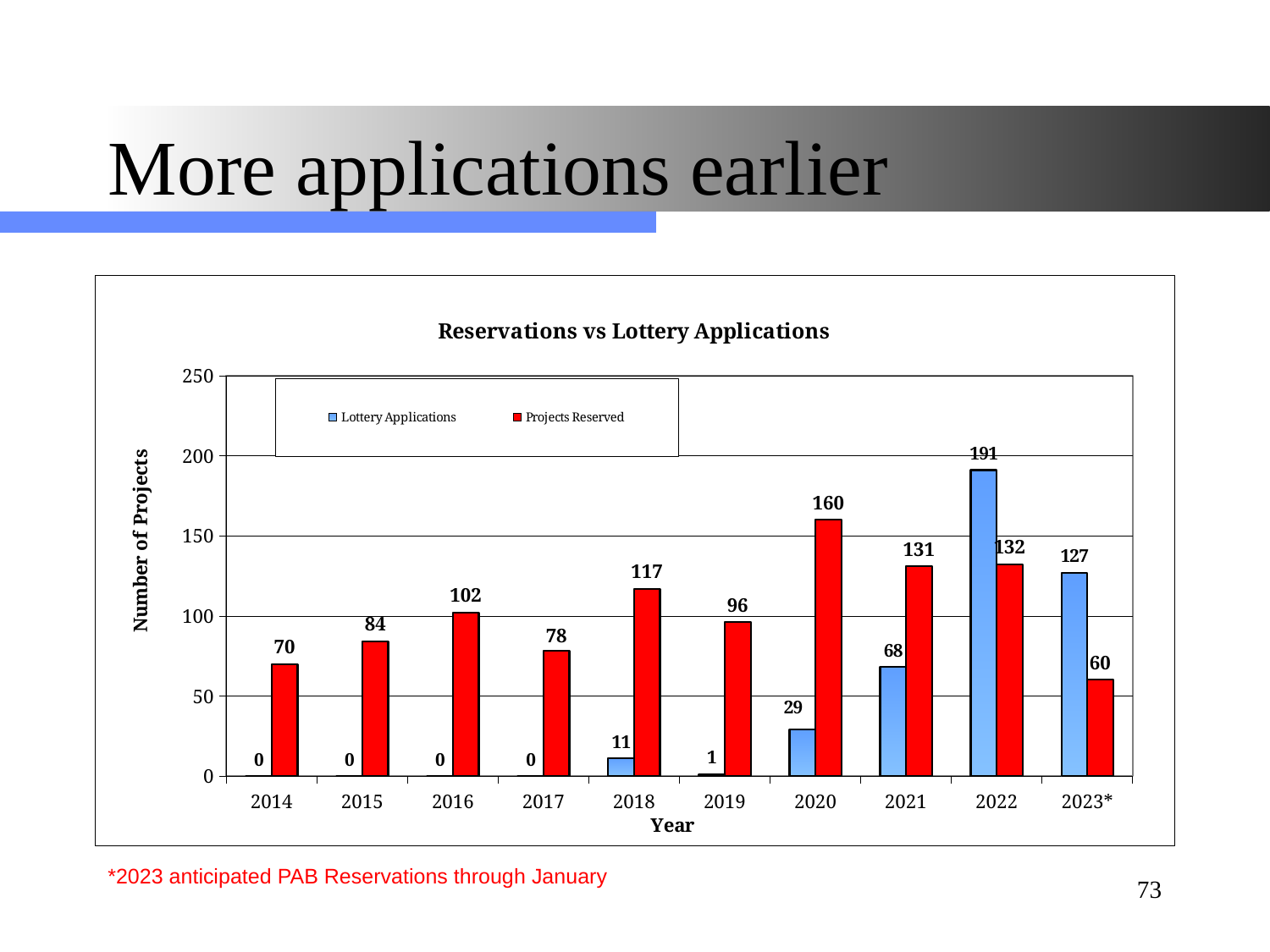
What kind of chart is shown? bar chart What is the value of Lottery Applications for 2022? 191 Which is larger in 2021: Lottery Applications or Projects Reserved? Projects Reserved Which year has the lowest value for Projects Reserved? 2023* Which year has the highest value for Projects Reserved? 2020 What is the difference between Lottery Applications and Projects Reserved in 2022? 59 What is the value of Lottery Applications for 2018? 11 How many series does the legend list? 2 Is the value of Projects Reserved for 2016 greater or less than 100? greater How many years are shown on the x axis? 10 What is the title of the chart? Reservations vs Lottery Applications What is the value of Projects Reserved for 2020? 160